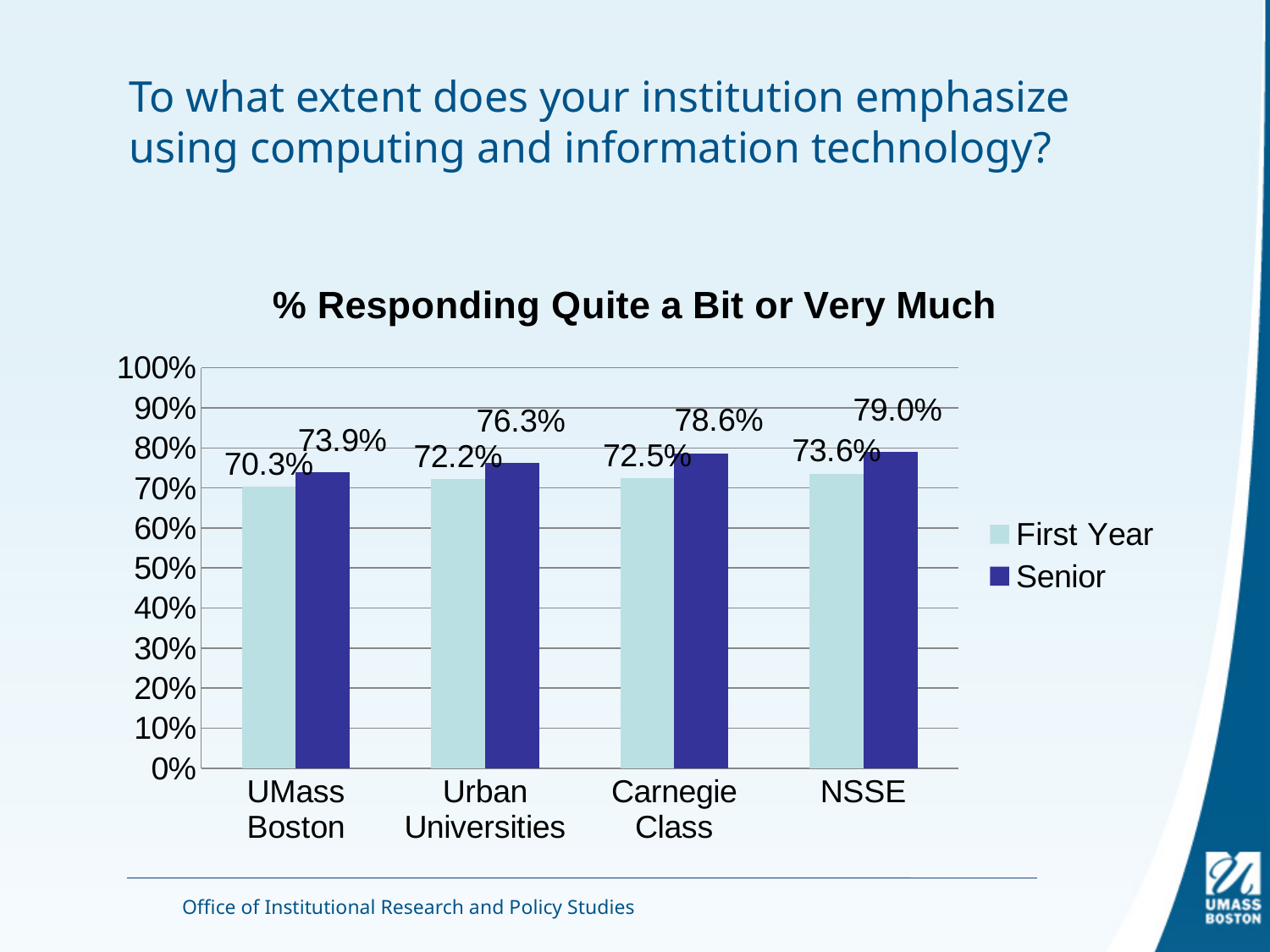
What is the First Year value for Carnegie Class? 72.5% What is the First Year value for UMass Boston? 70.3% What is the Senior value for NSSE? 79.0% What kind of chart is shown on the slide? Bar chart How many categories are shown on the x axis? 4 Which category has the highest Senior value? NSSE What is the title of the chart? % Responding Quite a Bit or Very Much What is the Senior value for Urban Universities? 76.3% How many series does the legend list? 2 Which is larger for Carnegie Class, the First Year value or the Senior value? Senior What is the difference between the Senior and First Year values for UMass Boston? 3.6% Which category has the lowest First Year value? UMass Boston